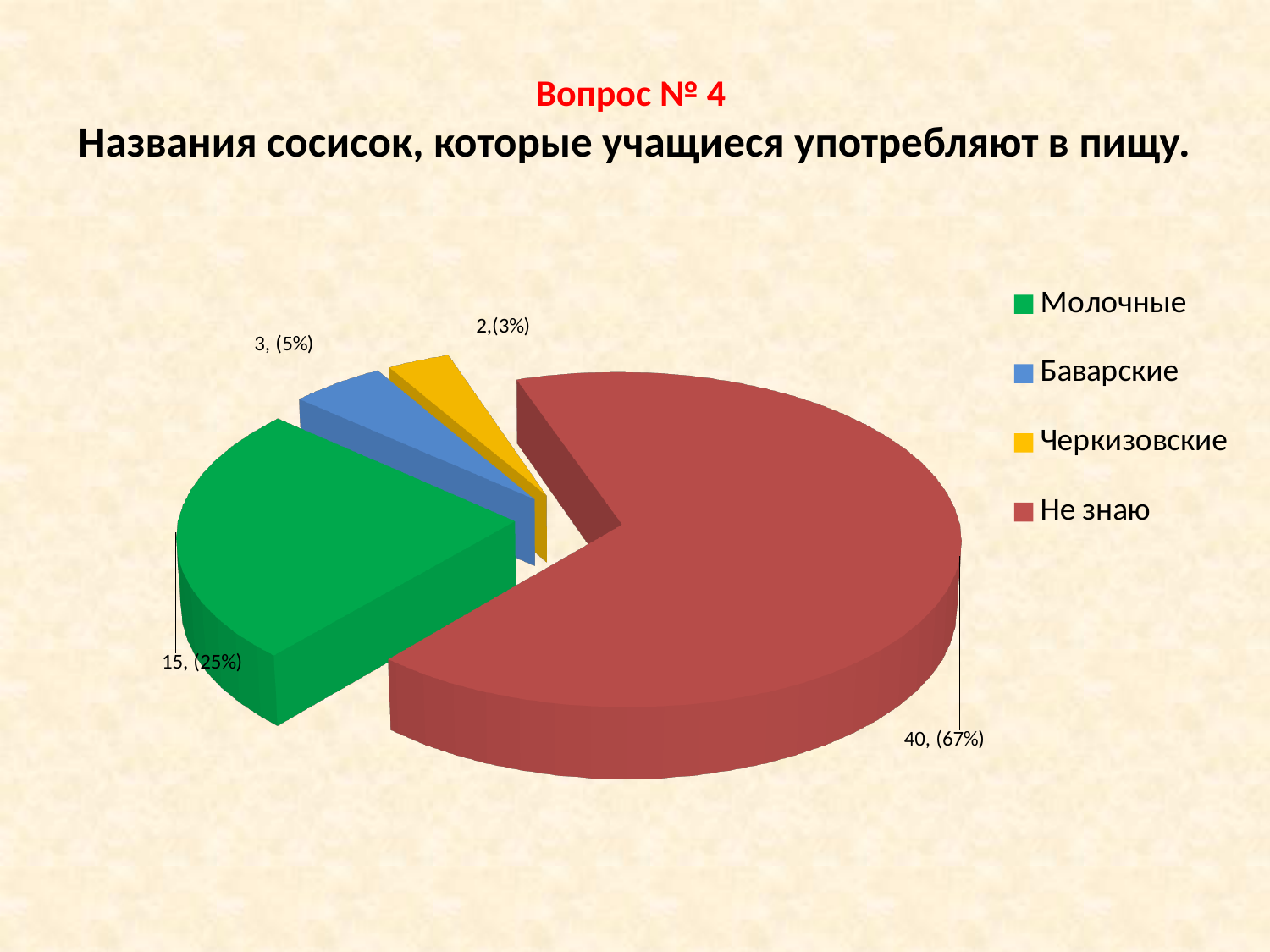
What is the value for Не знаю? 40 What share of the pie does Молочные represent? 25% Which category has the largest slice? Не знаю What is the value for Черкизовские? 2 Which category has the smallest slice? Черкизовские What kind of chart is shown on the slide? pie chart What is the difference between the values for Не знаю and Молочные? 25 How many entries does the legend list? 4 What is the value for Баварские? 3 Which colour represents Баварские in the chart? blue How many slices does the pie chart have? 4 What is the value for Молочные? 15